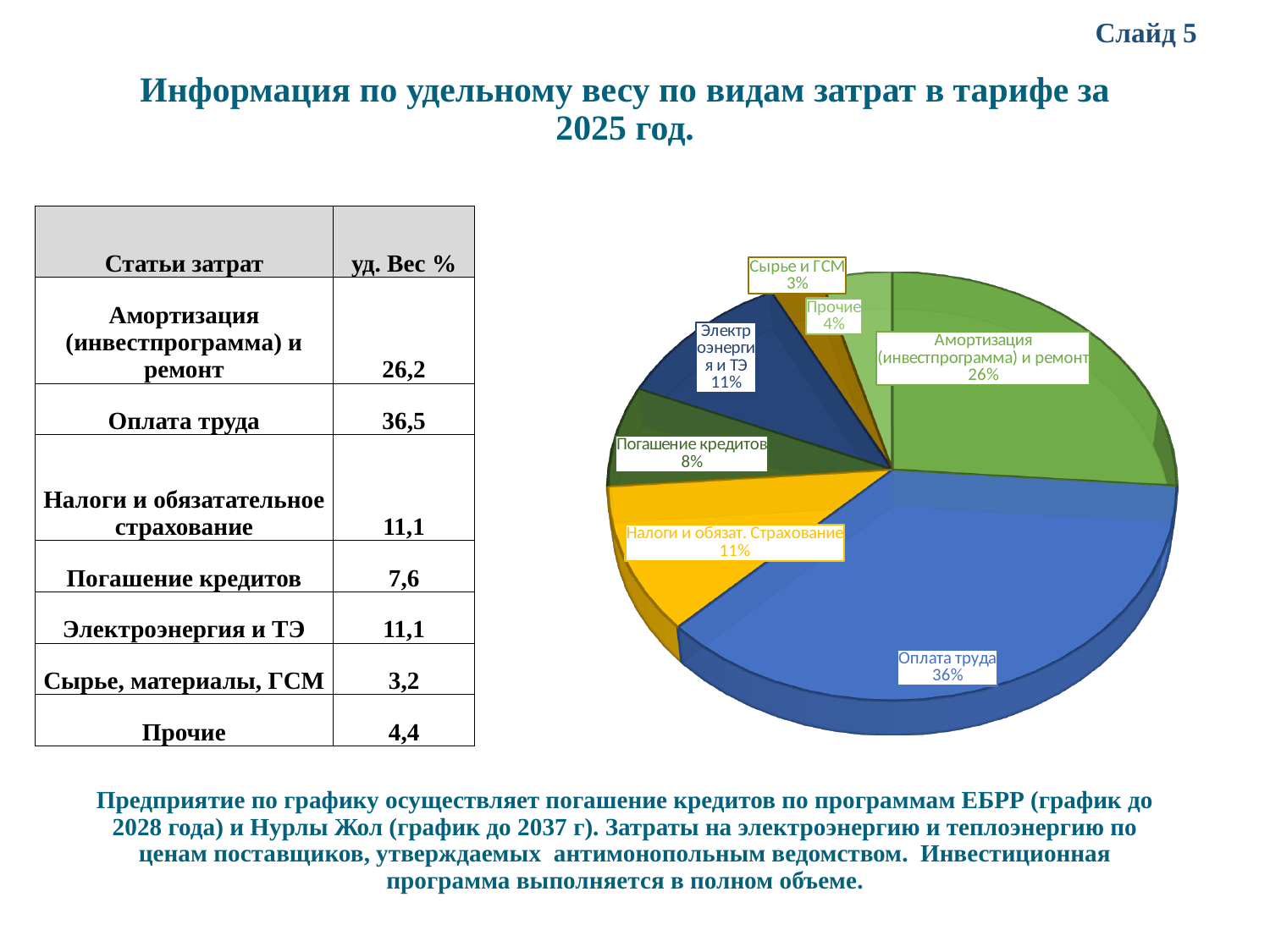
Which slice of the pie chart is the smallest? Сырье и ГСМ Which is larger in the pie chart: "Погашение кредитов" or "Электроэнергия и ТЭ"? Электроэнергия и ТЭ Which slice of the pie chart is the largest? Оплата труда What is the difference in percentage points between "Оплата труда" and "Амортизация (инвестпрограмма) и ремонт" in the pie chart? 10 What percentage is shown for "Погашение кредитов" in the pie chart? 8% How many slices does the pie chart have? 7 What share of the pie does "Амортизация (инвестпрограмма) и ремонт" have? 26% What share of the pie does "Оплата труда" have? 36% What colour is the "Оплата труда" slice in the pie chart? Blue What percentage is shown for "Прочие" in the pie chart? 4% What percentage is shown for "Сырье и ГСМ" in the pie chart? 3% What type of chart is shown on the slide? Pie chart